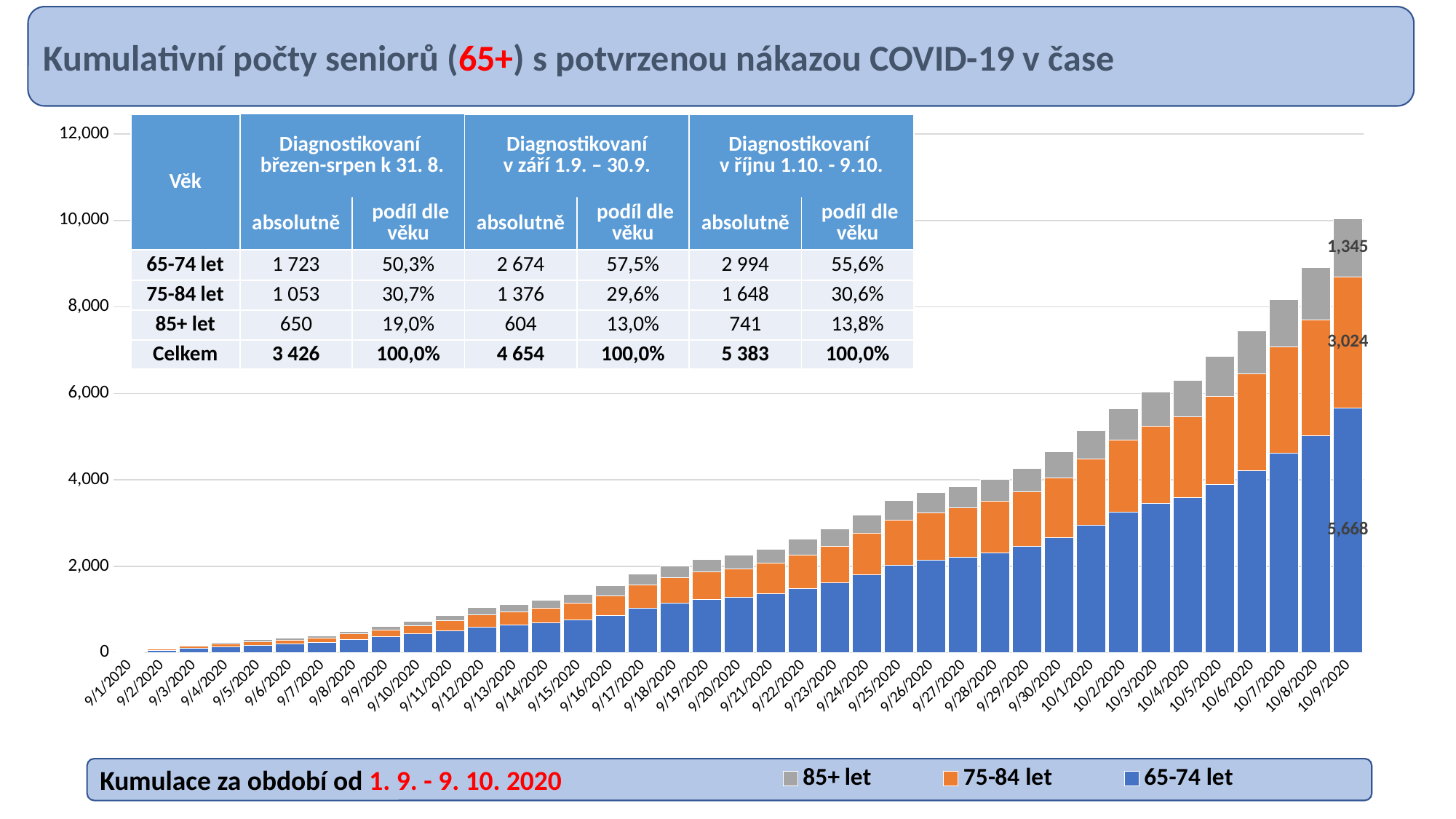
Which age group has the lowest value on 10/9/2020? 85+ let Do the stacked bar totals rise or fall from 9/1/2020 to 10/9/2020? rise How many series does the chart legend list? 3 How many dates are shown on the x axis of the chart? 39 What kind of chart is shown on the slide? stacked bar chart What is the total of the stacked bar for 10/9/2020? 10,037 Is the total stacked bar for 10/1/2020 greater or less than 4,000? greater What is the value for the 85+ let series on 10/9/2020? 1,345 What is the value for the 75-84 let series on 10/9/2020? 3,024 What is the difference between the 65-74 let and 75-84 let values on 10/9/2020? 2,644 What is the value for the 65-74 let series on 10/9/2020? 5,668 On 10/9/2020, which series has the larger value: 75-84 let or 85+ let? 75-84 let